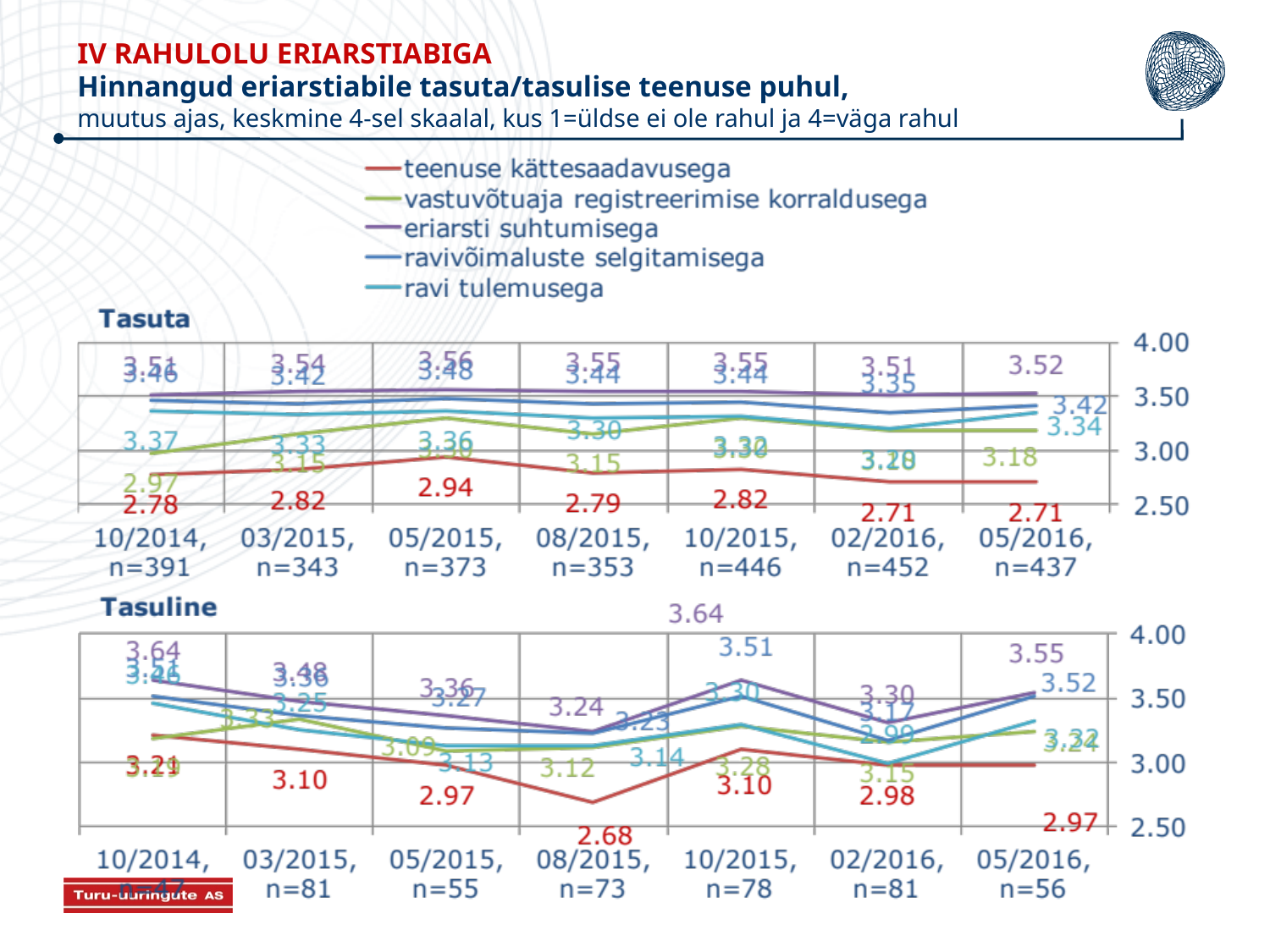
How many series does the legend list? 5 In the Tasuta chart, at which time point is 'teenuse kättesaadavusega' highest? 05/2015 In the Tasuta chart, is the value for 'teenuse kättesaadavusega' at 02/2016 greater or less than 3.00? less In the Tasuline chart, which is larger for 'teenuse kättesaadavusega': the value at 10/2014 or at 05/2016? 10/2014 In the Tasuta chart, what is the difference between the 'teenuse kättesaadavusega' values at 05/2015 and 10/2014? 0.16 In the Tasuline chart, what is the difference between the 'teenuse kättesaadavusega' values at 10/2014 and 08/2015? 0.53 In the Tasuline chart, what is the value for 'eriarsti suhtumisega' at 05/2016? 3.55 In the Tasuta chart, what is the value for 'teenuse kättesaadavusega' at 10/2014? 2.78 In the Tasuline chart, what is the value for 'teenuse kättesaadavusega' at 03/2015? 3.10 How many time points are plotted along the x axis of the Tasuline chart? 7 In the Tasuline chart, at which time point is 'teenuse kättesaadavusega' lowest? 08/2015 What kind of chart is the Tasuta chart? line chart